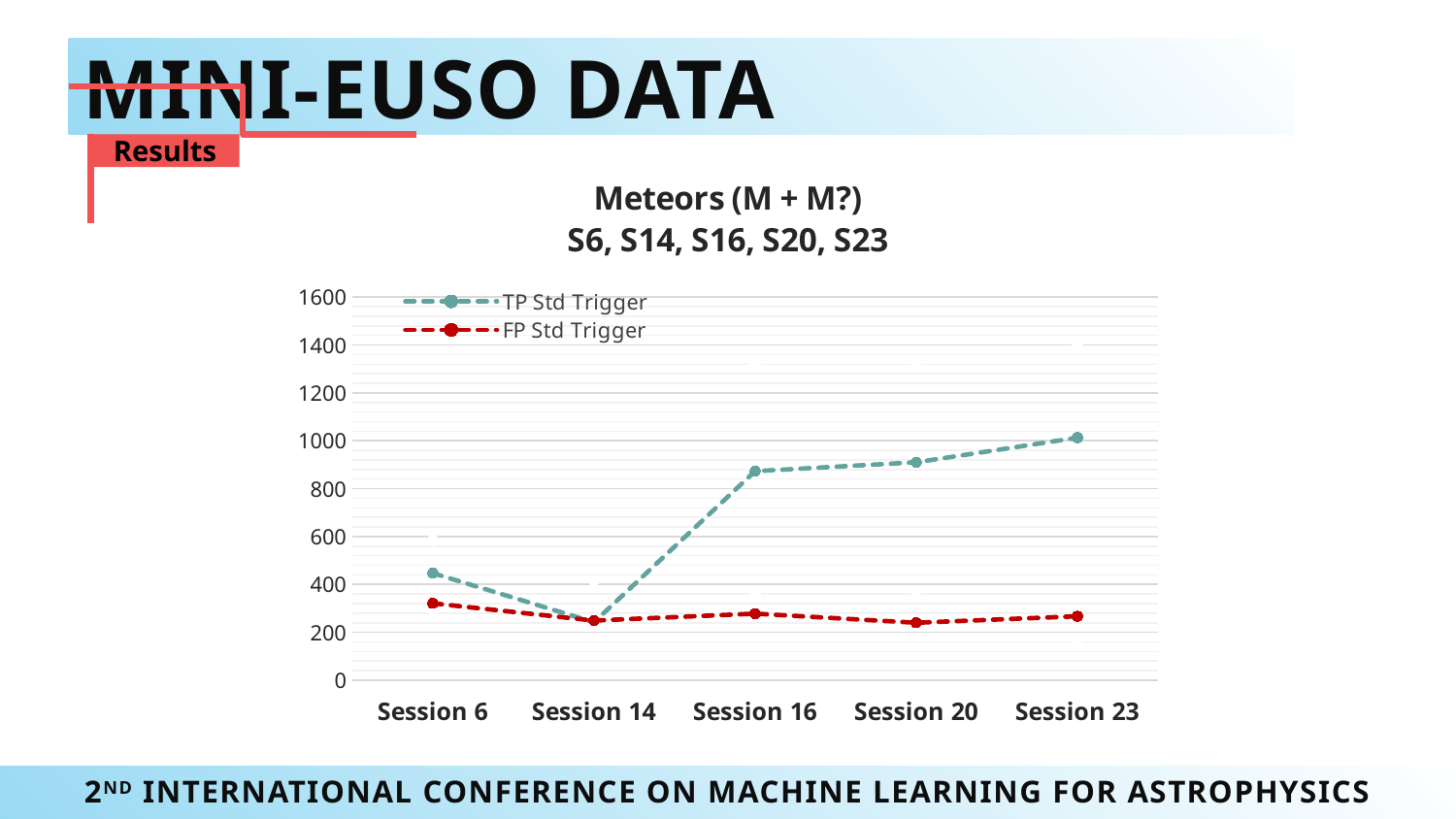
What is the title of the chart? Meteors (M + M?) S6, S14, S16, S20, S23 Does the TP Std Trigger series rise or fall from Session 14 to Session 23? rise How many sessions are plotted along the x axis? 5 Is the TP Std Trigger value for Session 14 greater or less than 400? less At which session is the TP Std Trigger value lowest? Session 14 Which series has the larger value at Session 20, TP Std Trigger or FP Std Trigger? TP Std Trigger At which session is the TP Std Trigger value highest? Session 23 Is the TP Std Trigger value for Session 16 greater or less than 800? greater How many series does the legend list? 2 At which session is the FP Std Trigger value highest? Session 6 Which series is drawn in red? FP Std Trigger What kind of chart is shown on the slide? line chart